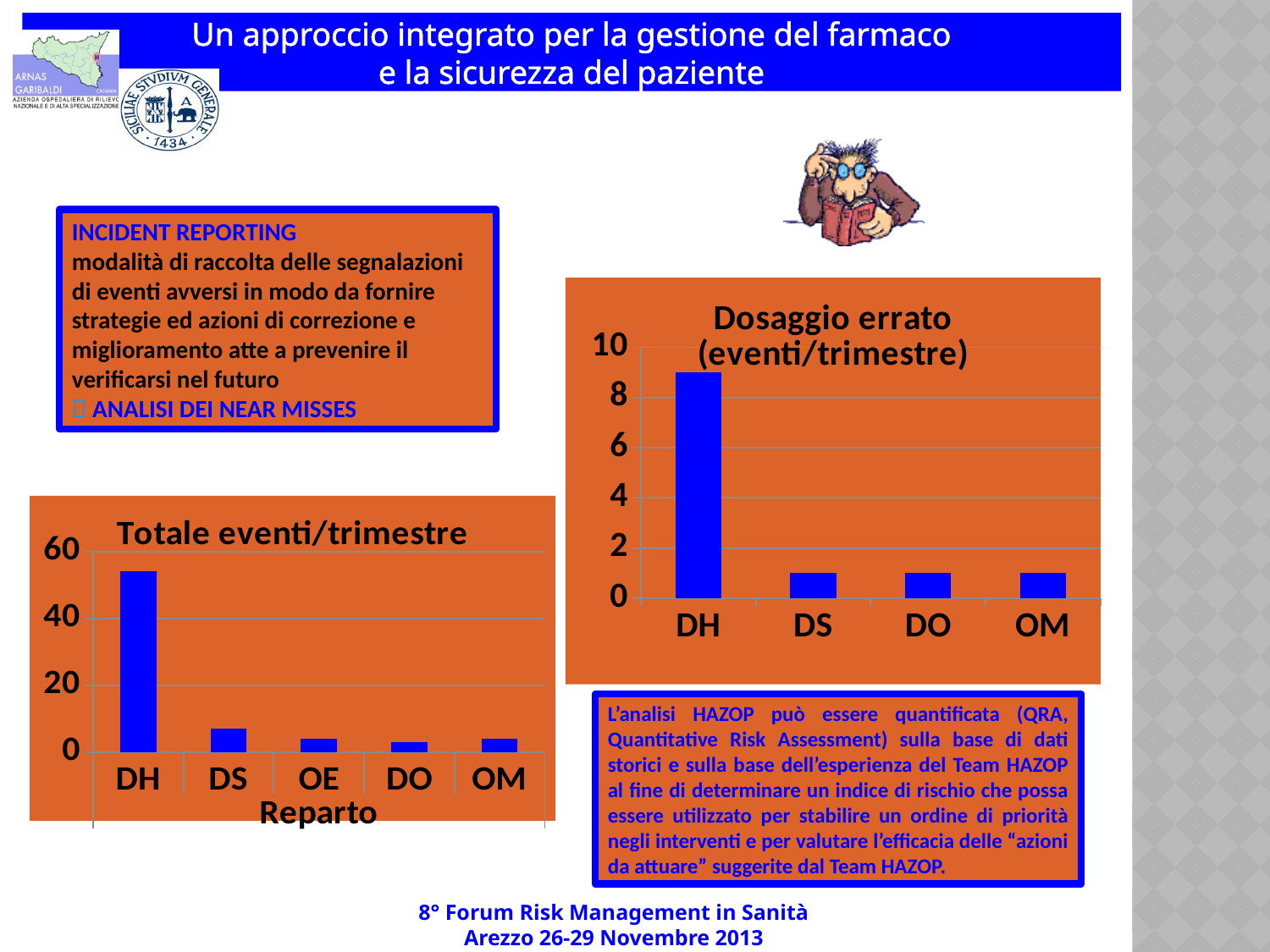
In the "Dosaggio errato (eventi/trimestre)" chart, which category has the highest value? DH In the "Dosaggio errato (eventi/trimestre)" chart, is the value for DH greater or less than 8? greater What is the x-axis title of the "Totale eventi/trimestre" chart? Reparto How many categories are shown on the x axis of the "Totale eventi/trimestre" chart? 5 In the "Totale eventi/trimestre" chart, is the value for DS greater or less than 20? less How many categories are shown on the x axis of the "Dosaggio errato (eventi/trimestre)" chart? 4 In the "Totale eventi/trimestre" chart, which category has the highest value? DH In the "Totale eventi/trimestre" chart, which is larger, the value for DH or the value for DS? DH In the "Dosaggio errato (eventi/trimestre)" chart, which is larger, the value for DH or the value for OM? DH In the "Dosaggio errato (eventi/trimestre)" chart, is the value for DS greater or less than 2? less What kind of chart is the "Totale eventi/trimestre" chart? bar chart